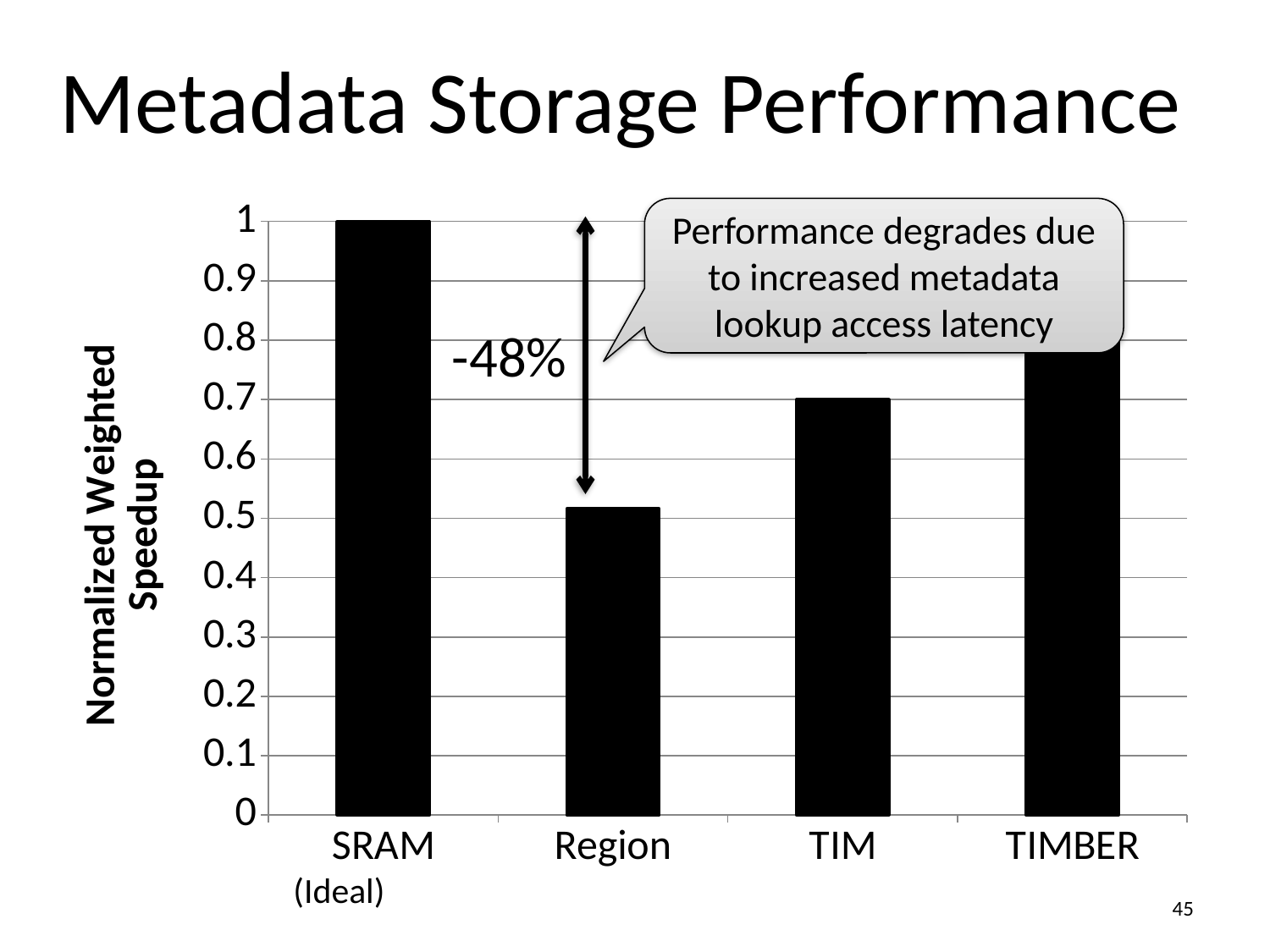
What is the normalized weighted speedup for SRAM (Ideal)? 1 What is the label of the y axis? Normalized Weighted Speedup Is the value for Region greater or less than 0.6? less Is the value for Region greater or less than 0.5? greater Which has a larger normalized weighted speedup, TIMBER or TIM? TIMBER Is the value for TIMBER greater or less than 0.7? greater Which has a larger normalized weighted speedup, TIM or Region? TIM Which category has the highest normalized weighted speedup? SRAM (Ideal) How many categories are shown on the x axis? 4 Which category has the lowest normalized weighted speedup? Region What kind of chart is shown on the slide? bar chart What percentage change is annotated between the SRAM (Ideal) and Region bars? -48%